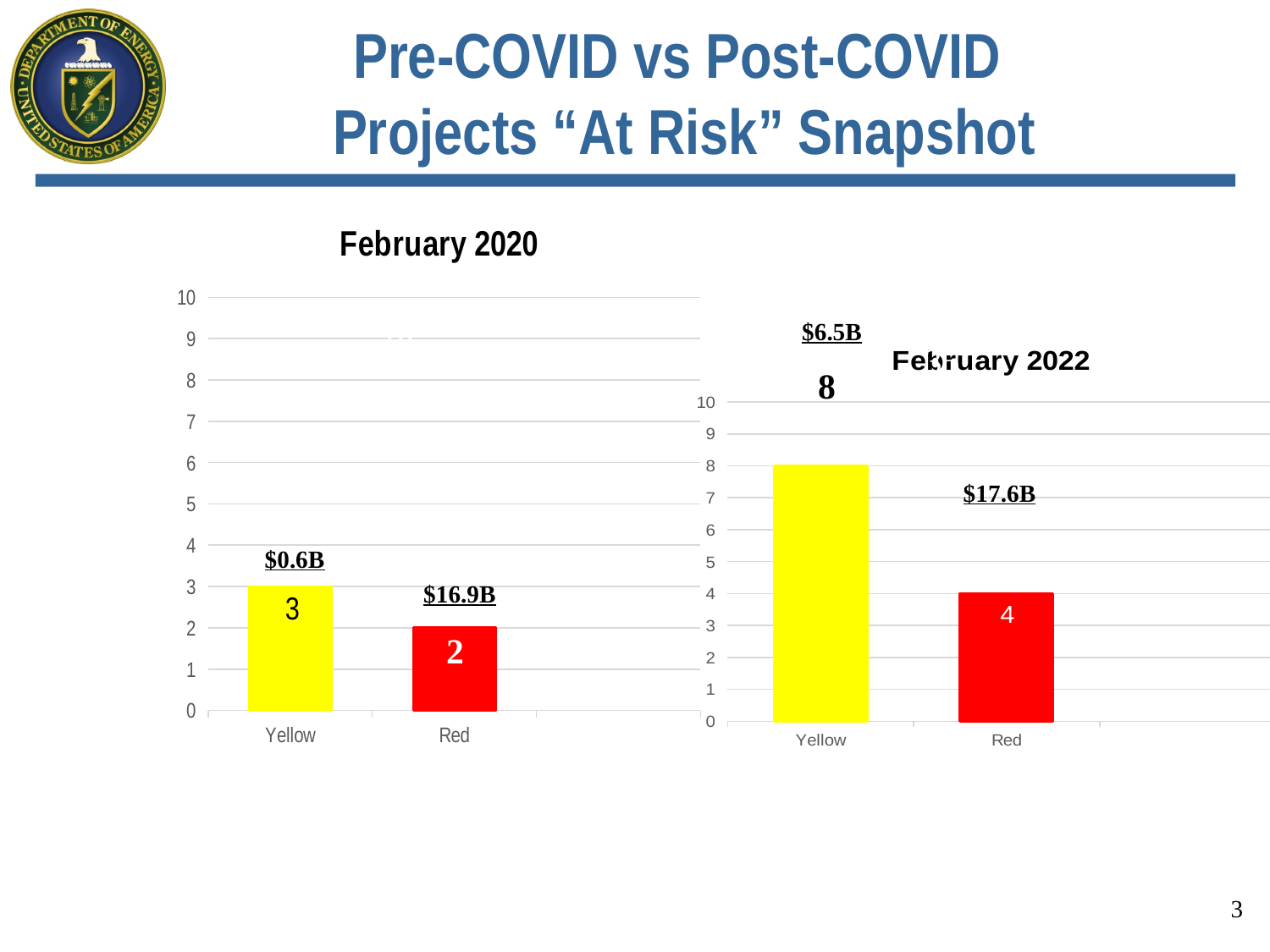
What kind of chart is the February 2022 chart? bar chart In the February 2020 chart, which category has the lowest value? Red In the February 2022 chart, what is the value for Red? 4 In the February 2020 chart, which is larger, the value for Yellow or the value for Red? Yellow In the February 2020 chart, what is the value for Red? 2 In the February 2022 chart, is the value for Yellow greater or less than 5? greater In the February 2022 chart, what is the value for Yellow? 8 In the February 2022 chart, which category has the highest value? Yellow In the February 2020 chart, what is the value for Yellow? 3 In the February 2022 chart, what dollar amount is annotated above the Red bar? $17.6B In the February 2022 chart, what is the difference between the Yellow and Red values? 4 How many categories are shown in the February 2020 chart? 2